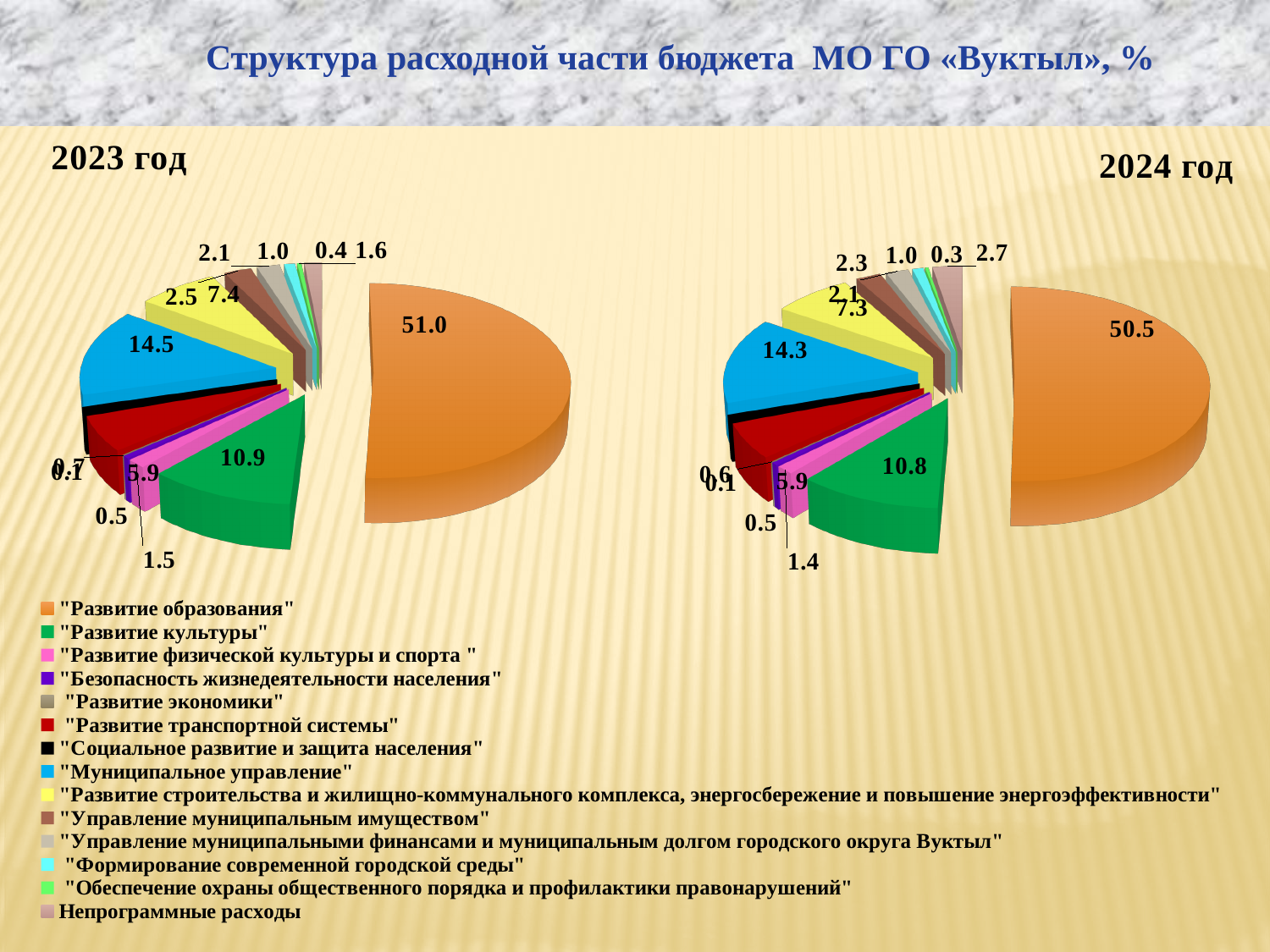
In the 2023 pie chart, what is the value for "Развитие образования"? 51.0 In the 2023 pie chart, what is the value for "Развитие культуры"? 10.9 In the 2023 pie chart, which category has the largest share? "Развитие образования" In the 2024 pie chart, what is the value for "Развитие физической культуры и спорта"? 1.4 What kind of charts are shown on the slide? Pie charts By how much does the value for "Развитие образования" in the 2023 chart exceed the value in the 2024 chart? 0.5 How many categories does the legend list? 14 What is the title of the slide? Структура расходной части бюджета МО ГО «Вуктыл», % In the 2024 pie chart, what is the value for "Муниципальное управление"? 14.3 In the 2024 pie chart, what is the value for "Развитие образования"? 50.5 What is the difference between the values for "Муниципальное управление" in the 2023 chart and the 2024 chart? 0.2 Is the value for "Развитие культуры" larger in the 2023 chart or the 2024 chart? 2023